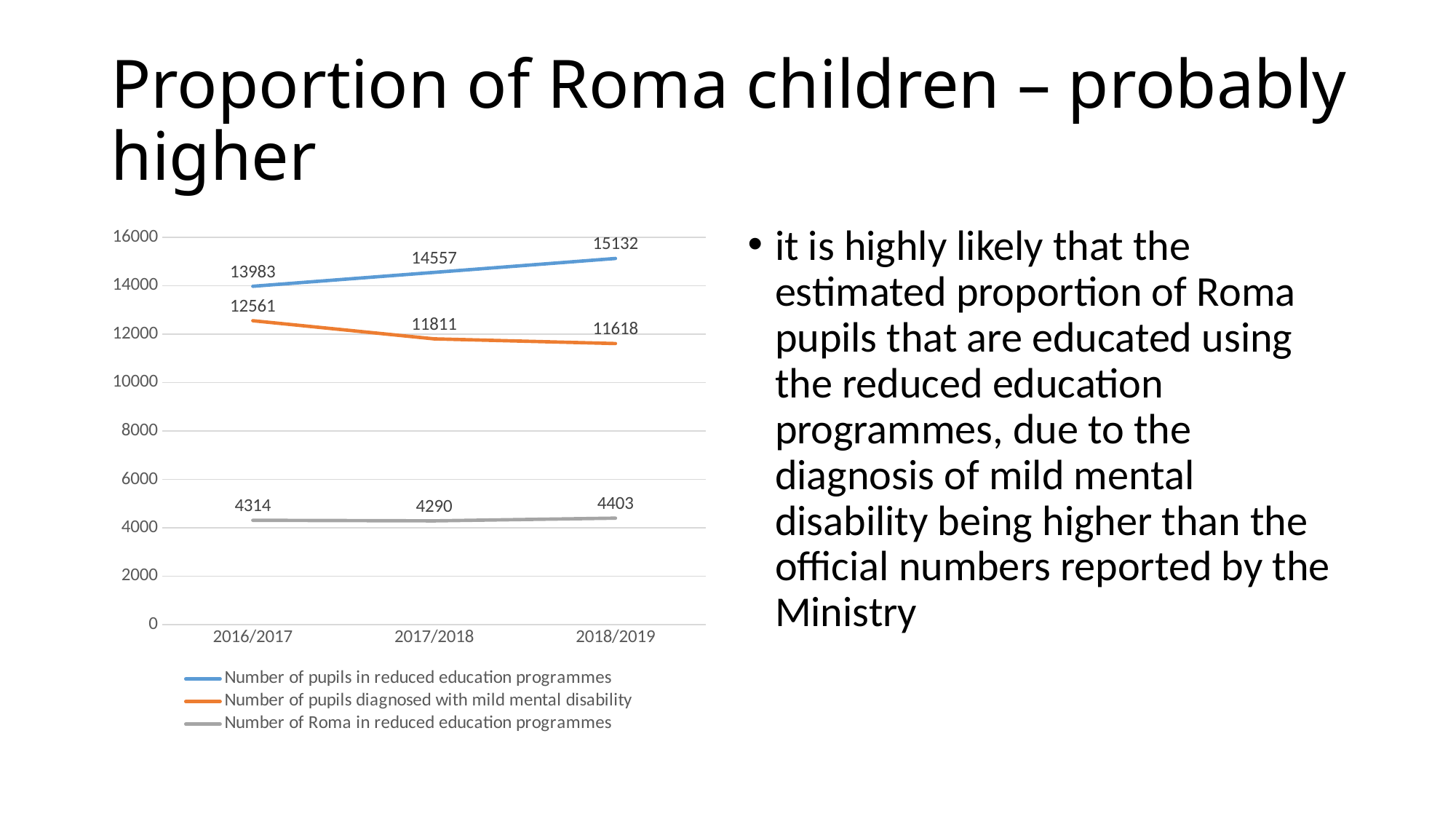
What is the difference between the number of pupils in reduced education programmes and the number of pupils diagnosed with mild mental disability in 2018/2019? 3514 In which school year is the number of pupils in reduced education programmes highest? 2018/2019 What is the number of pupils in reduced education programmes in 2018/2019? 15132 What is the number of pupils diagnosed with mild mental disability in 2016/2017? 12561 How many series does the legend list? 3 Which is larger in 2016/2017: the number of pupils in reduced education programmes or the number of pupils diagnosed with mild mental disability? Number of pupils in reduced education programmes What is the number of Roma in reduced education programmes in 2017/2018? 4290 How many points are plotted on the x axis? 3 What colour is the line for the number of Roma in reduced education programmes? grey In which school year is the number of pupils diagnosed with mild mental disability lowest? 2018/2019 Does the number of pupils in reduced education programmes rise or fall from 2016/2017 to 2018/2019? rise What kind of chart is shown on the slide? line chart